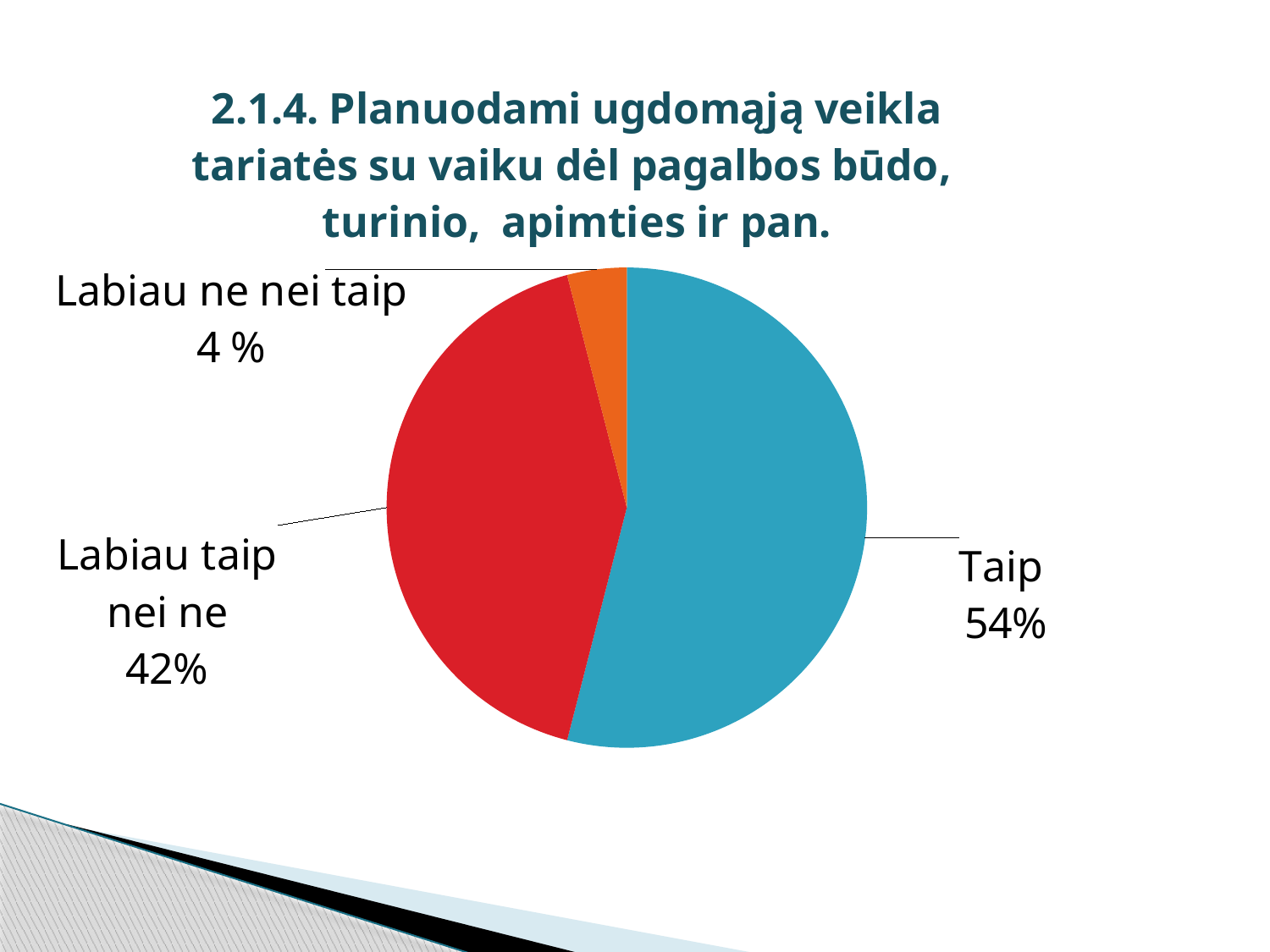
What percentage of the pie is labelled "Labiau ne nei taip"? 4 % What percentage of the pie is labelled "Labiau taip nei ne"? 42% Which is larger, the "Labiau taip nei ne" slice or the "Labiau ne nei taip" slice? Labiau taip nei ne Which slice of the pie is the largest? Taip What is the difference in percentage points between the "Taip" slice and the "Labiau taip nei ne" slice? 12 What colour is the "Taip" slice? Blue What percentage of the pie is labelled "Taip"? 54% What colour is the "Labiau taip nei ne" slice? Red How many slices does the pie chart have? 3 Which slice of the pie is the smallest? Labiau ne nei taip What kind of chart is shown on the slide? Pie chart